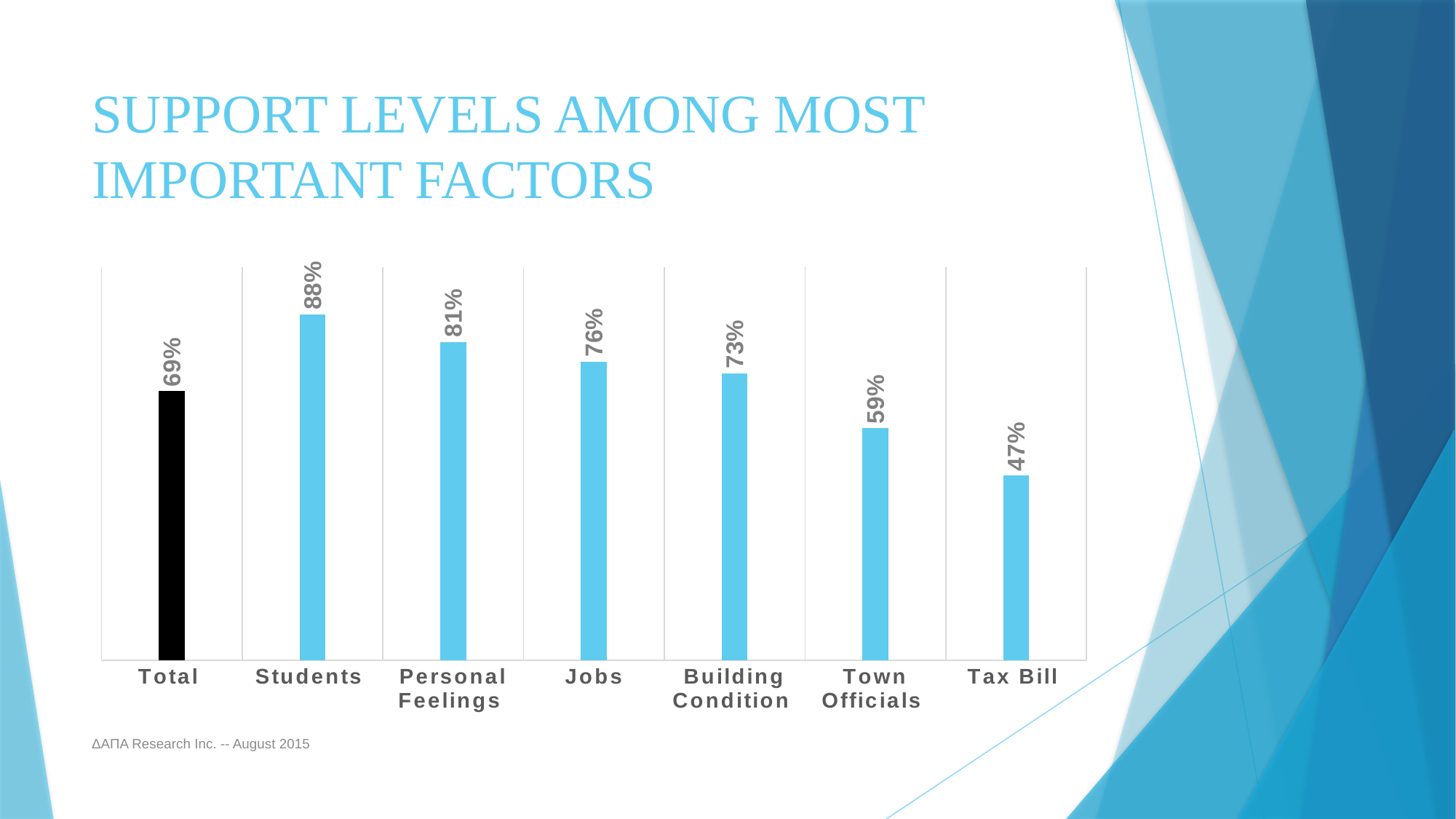
What kind of chart is shown on the slide? Bar chart Which category has the lowest support level? Tax Bill What is the difference between the support levels for Personal Feelings and Jobs? 5% What is the support level for Tax Bill? 47% Which has a higher support level, Jobs or Town Officials? Jobs How many categories are shown on the x axis? 7 What is the value shown for Total? 69% What is the difference between the support levels for Students and Tax Bill? 41% Which bar is coloured black rather than blue? Total What is the support level for Students? 88% What is the support level for Building Condition? 73% Which category has the highest support level? Students